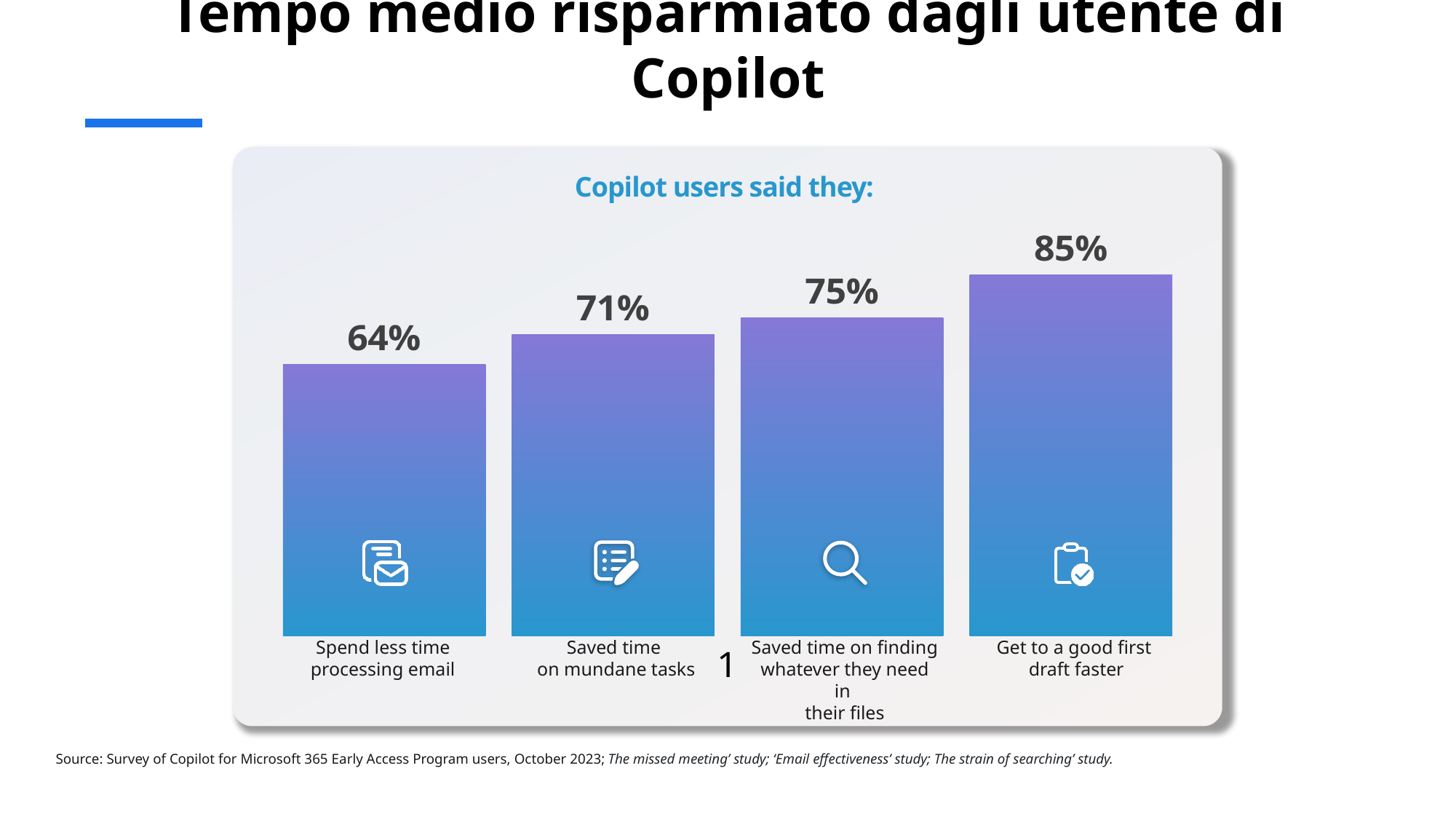
Which category has the lowest percentage? Spend less time processing email What percentage of Copilot users said they saved time on finding whatever they need in their files? 75% Which is larger: the percentage for 'Saved time on mundane tasks' or 'Spend less time processing email'? Saved time on mundane tasks What is the difference between the percentage for 'Saved time on finding whatever they need in their files' and 'Saved time on mundane tasks'? 4% What percentage of Copilot users said they saved time on mundane tasks? 71% What is the difference between the percentage for 'Get to a good first draft faster' and 'Spend less time processing email'? 21% How many categories are shown in the chart? 4 What percentage of Copilot users said they spend less time processing email? 64% What percentage of Copilot users said they get to a good first draft faster? 85% Do the values rise or fall from left to right across the chart? Rise Which category has the highest percentage? Get to a good first draft faster What kind of chart is shown on the slide? Bar chart